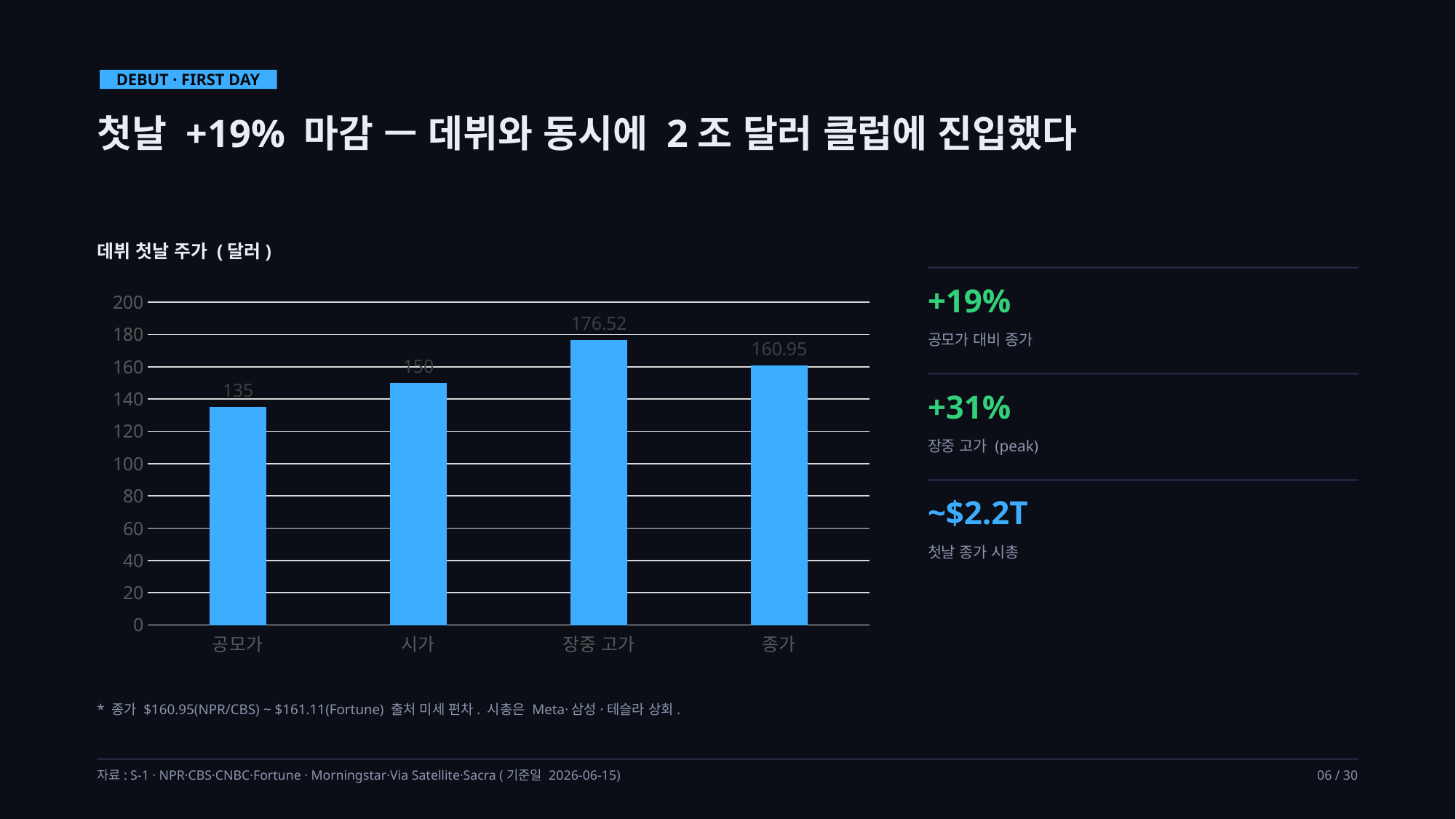
What is the value for 공모가 in the chart? 135 Is the value for 시가 greater or less than 140? greater Which category has the lowest value in the chart? 공모가 What is the value for 장중 고가 in the chart? 176.52 What is the difference between the values for 장중 고가 and 공모가? 41.52 What is the difference between the values for 종가 and 공모가? 25.95 What is the value for 시가 in the chart? 150 Which is larger, the value for 종가 or the value for 시가? 종가 What is the value for 종가 in the chart? 160.95 Which category has the highest value in the chart? 장중 고가 How many categories are shown in the chart? 4 What kind of chart is shown on the slide? bar chart